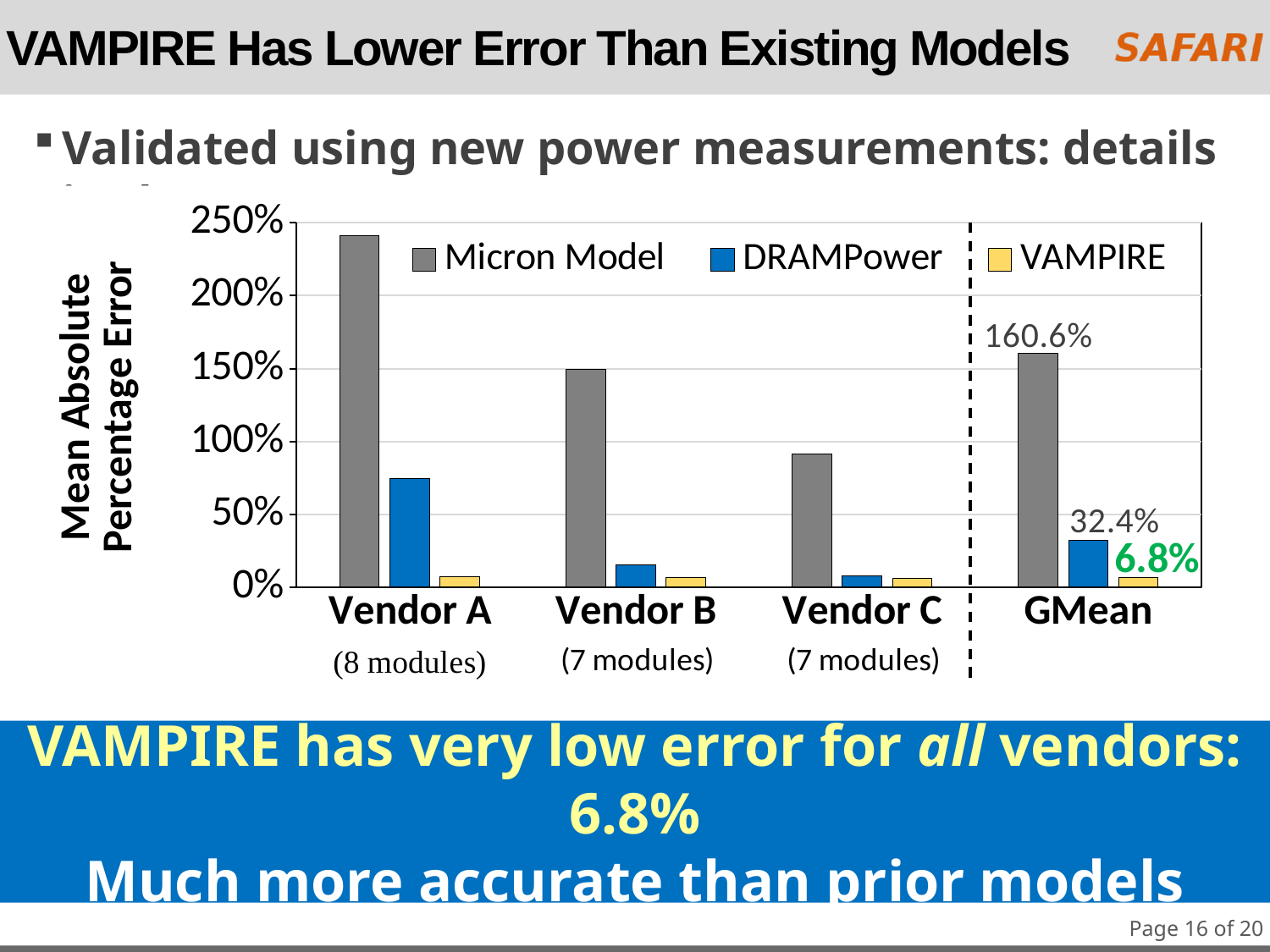
Is the Micron Model value for Vendor A greater or less than 200%? greater Is the Micron Model value for Vendor C greater or less than 100%? less For GMean, what is the difference between the Micron Model value and the DRAMPower value? 128.2% What is the VAMPIRE value for GMean? 6.8% Among Vendor A, Vendor B and Vendor C, which has the lowest Micron Model error? Vendor C Which vendor has the highest Micron Model error? Vendor A For GMean, what is the difference between the DRAMPower value and the VAMPIRE value? 25.6% What is the DRAMPower value for GMean? 32.4% What kind of chart is shown on the slide? bar chart How many series does the legend list? 3 What is the Micron Model value for GMean? 160.6% Which is larger, the DRAMPower value for Vendor A or the DRAMPower value for Vendor B? Vendor A